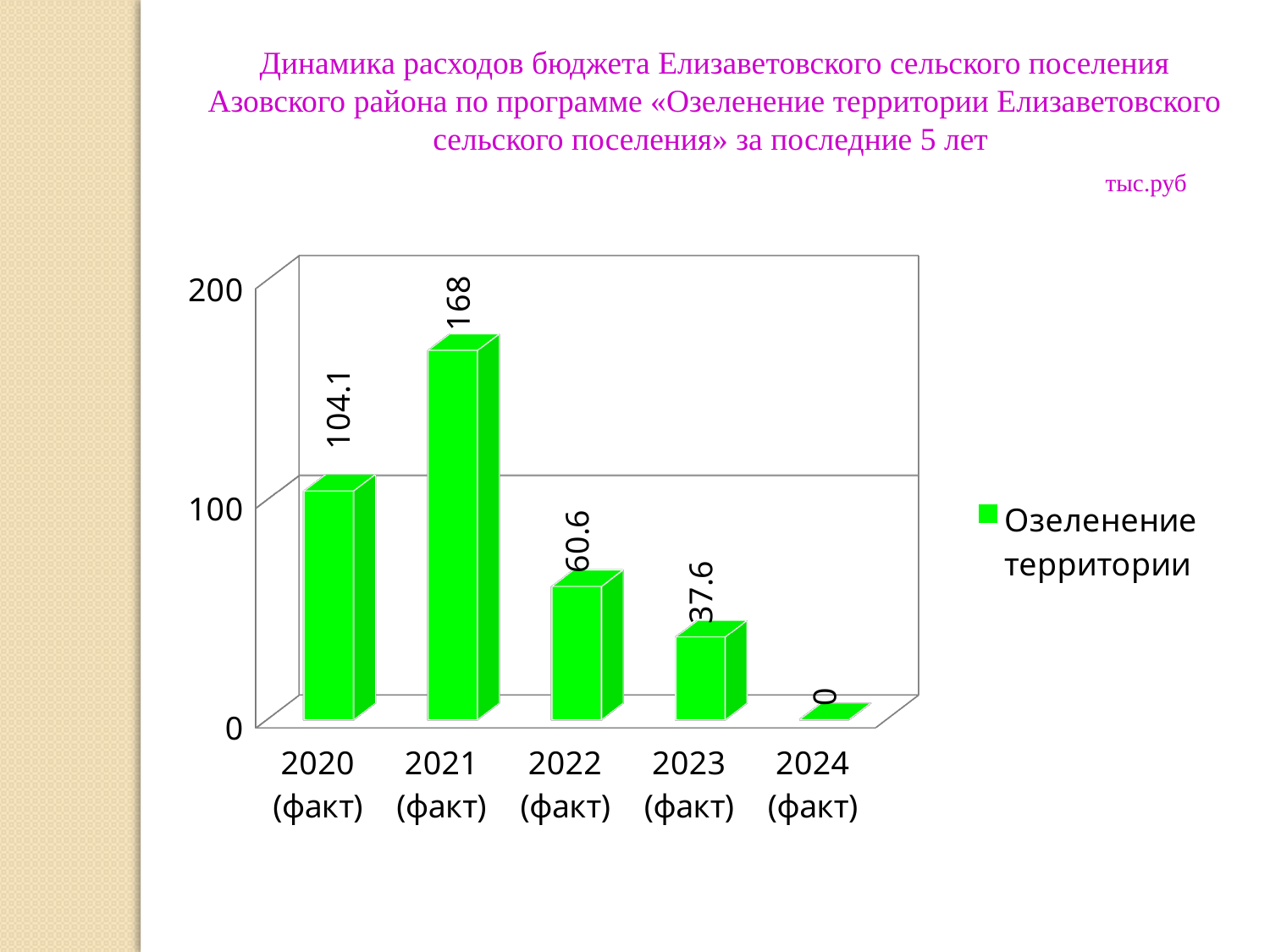
Do the values rise or fall from 2021 (факт) to 2024 (факт)? fall What is the value for 2021 (факт)? 168 How many categories are shown on the x axis? 5 What kind of chart is shown on the slide? bar chart What is the difference between the values for 2021 (факт) and 2022 (факт)? 107.4 What is the value for 2024 (факт)? 0 Is the value for 2021 (факт) greater or less than 100? greater Which year has the lowest value? 2024 (факт) Which is larger, the value for 2020 (факт) or the value for 2022 (факт)? 2020 (факт) Which year has the highest value? 2021 (факт) What is the value for 2023 (факт)? 37.6 What is the value for 2020 (факт)? 104.1